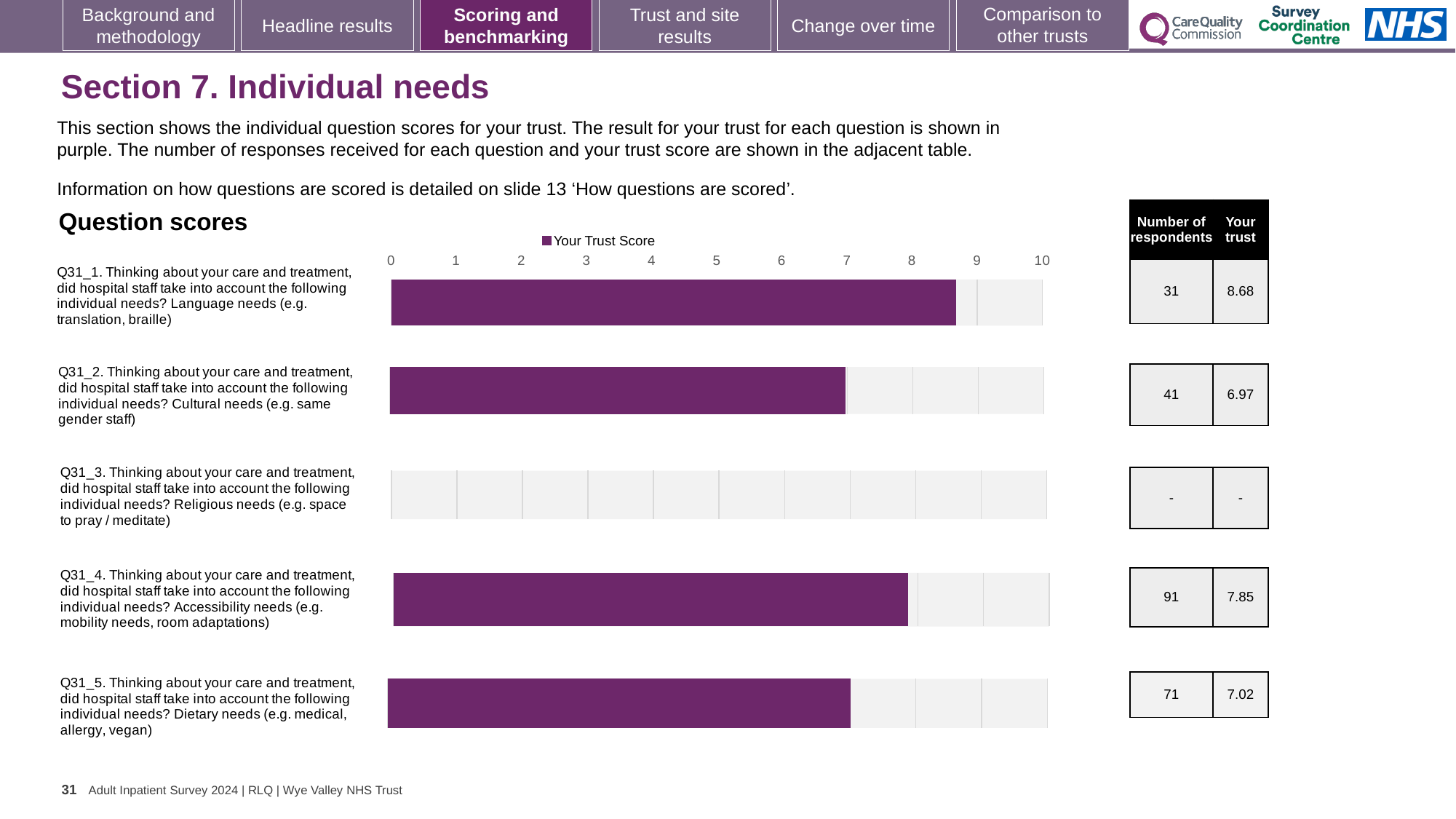
Which question has no trust score shown (marked with a dash)? Q31_3 (Religious needs) How many respondents answered Q31_5 (Dietary needs)? 71 What type of chart is used to show the question scores? Bar chart What is the difference between the trust scores for Q31_1 and Q31_2? 1.71 Is the trust score bar for Q31_2 (Cultural needs) greater or less than 8? less Which has the larger trust score, Q31_4 (Accessibility needs) or Q31_5 (Dietary needs)? Q31_4 (Accessibility needs) What is the trust score for Q31_4 (Accessibility needs)? 7.85 How many series does the chart legend list? 1 Among the questions with a score shown, which has the lowest trust score? Q31_2 (Cultural needs) How many questions are shown in the Question scores section? 5 Which question has the highest trust score on this slide? Q31_1 (Language needs) What is the trust score for Q31_1 (Language needs)? 8.68